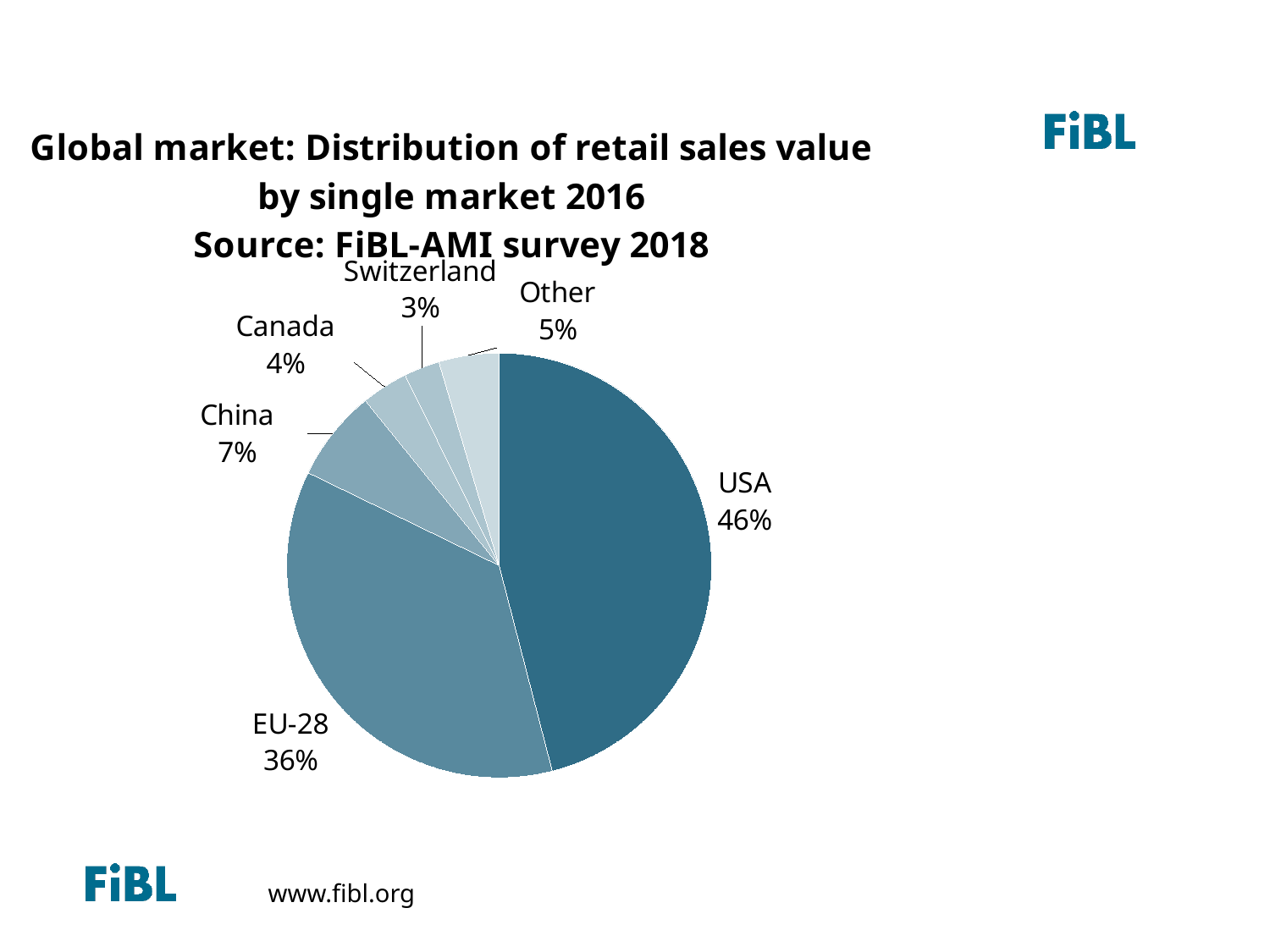
What share of retail sales value does the USA hold? 46% What is the difference in percentage points between the USA and EU-28 shares? 10 What share of retail sales value does China hold? 7% What share of retail sales value does the EU-28 hold? 36% Which market has the smallest share of retail sales value? Switzerland Which has a larger share, China or Other? China How many slices does the pie chart have? 6 What is the title of the chart? Global market: Distribution of retail sales value by single market 2016 What share of retail sales value does Switzerland hold? 3% What share of retail sales value does Canada hold? 4% Which market has the largest share of retail sales value? USA What kind of chart is shown on the slide? Pie chart